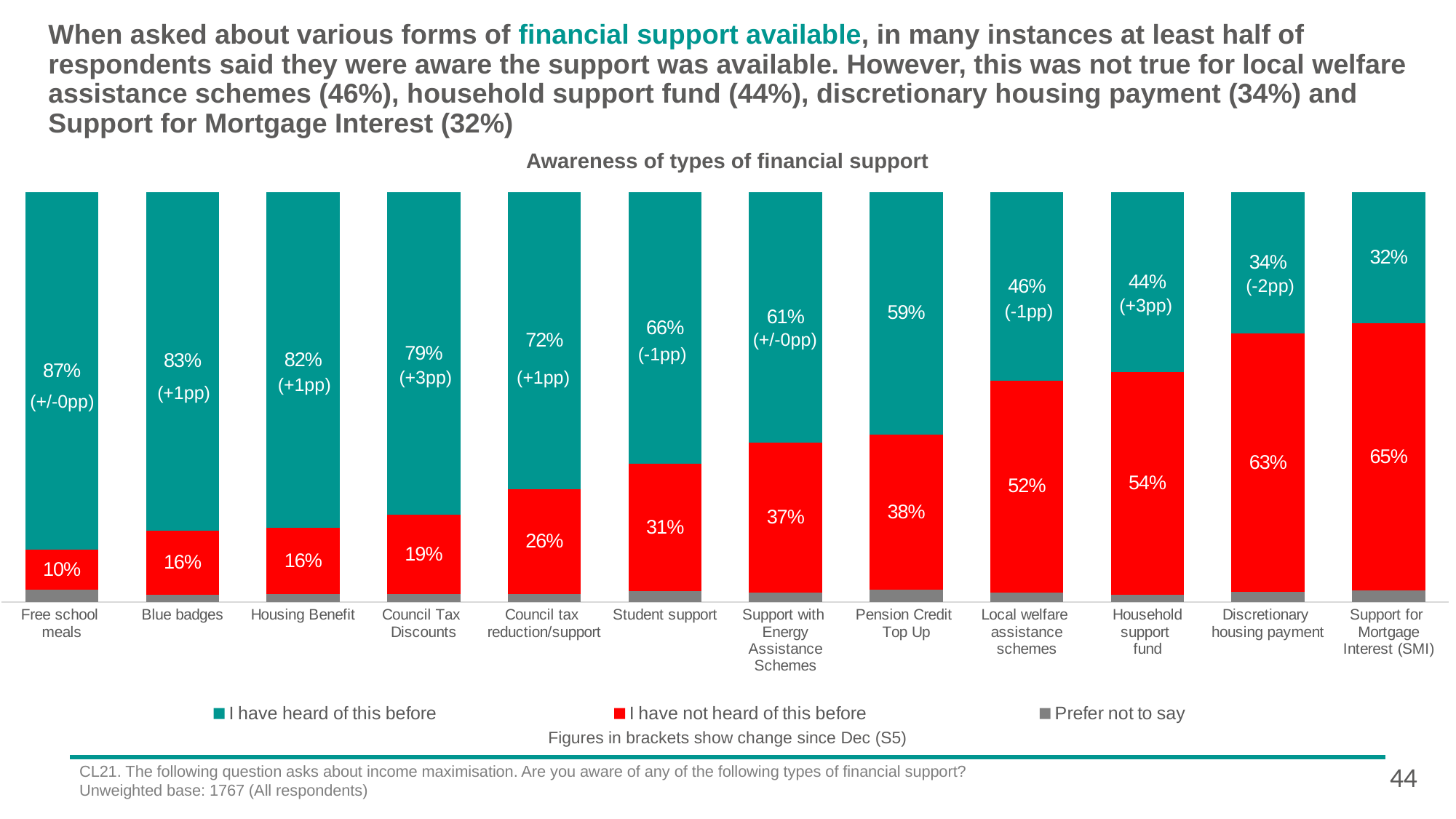
What percentage of respondents said they had heard of Free school meals before? 87% What percentage of respondents said they had not heard of Support for Mortgage Interest (SMI) before? 65% How many series does the legend list? 3 What is the 'I have heard of this before' value for Council tax reduction/support? 72% Which has a larger 'I have not heard of this before' value: Student support or Pension Credit Top Up? Pension Credit Top Up What kind of chart is shown on the slide? Stacked bar chart What is the difference between the 'I have heard of this before' values for Free school meals and Support for Mortgage Interest (SMI)? 55 percentage points Do the 'I have heard of this before' values rise or fall moving from left to right along the x axis? Fall What change since Dec (S5) is shown in brackets for Household support fund? +3pp Which type of financial support has the highest 'I have heard of this before' value? Free school meals How many types of financial support are shown on the x axis? 12 Which type of financial support has the lowest 'I have heard of this before' value? Support for Mortgage Interest (SMI)